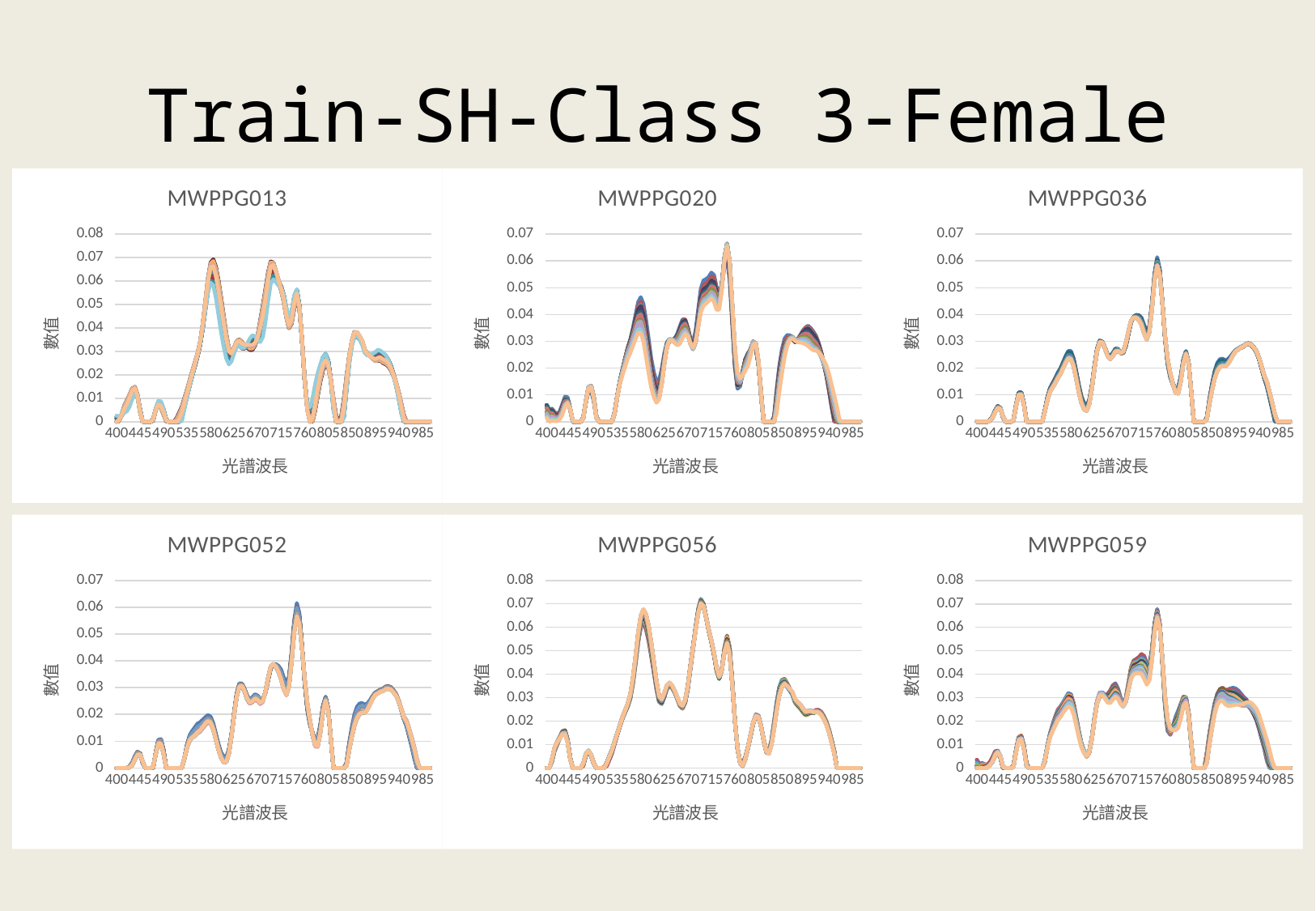
In the MWPPG059 chart, is the value at 400 greater or less than 0.02? less In the MWPPG052 chart, is the peak value near 760 greater or less than 0.05? greater What is the title of the chart in the bottom-right position? MWPPG059 In the MWPPG020 chart, what is the first value shown on the x axis? 400 What kind of chart is MWPPG013? line chart In the MWPPG036 chart, is the peak value near 760 greater or less than 0.05? greater In the MWPPG020 chart, what is the highest value shown on the y axis? 0.07 How many charts are shown on the slide? 6 In the MWPPG013 chart, what is the highest value shown on the y axis? 0.08 What is the title of the chart in the top-left position? MWPPG013